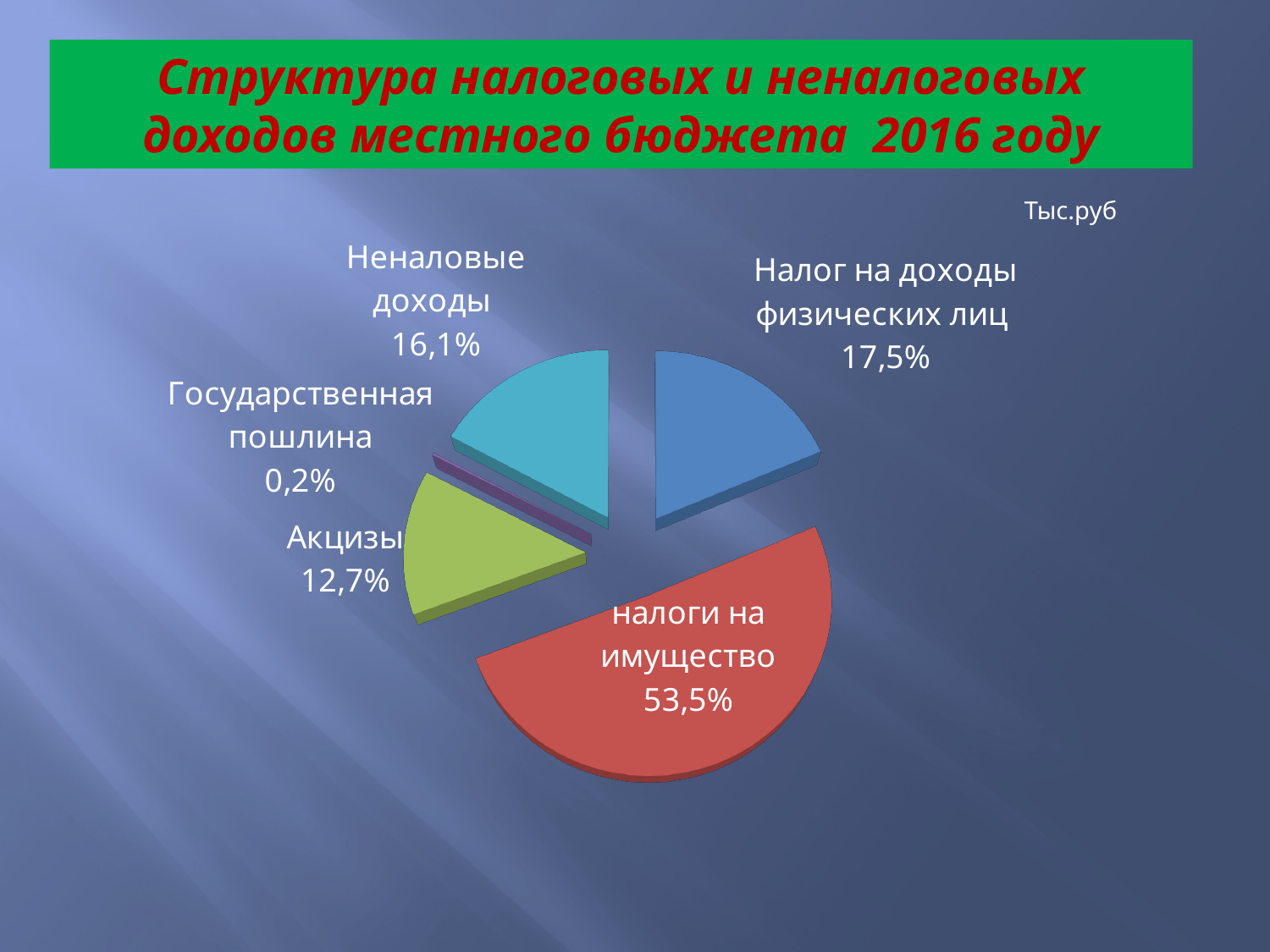
Which is larger: Налог на доходы физических лиц or Неналовые доходы? Налог на доходы физических лиц Which category has the smallest share of the pie? Государственная пошлина What is the value for Налог на доходы физических лиц? 17,5% What type of chart is shown on the slide? pie chart What is the value for Акцизы? 12,7% What colour is the slice for налоги на имущество? red What share of the pie is налоги на имущество? 53,5% Which category has the largest share of the pie? налоги на имущество How many slices does the pie chart have? 5 What is the value for Неналовые доходы? 16,1% What is the value for Государственная пошлина? 0,2% What is the difference between налоги на имущество and Налог на доходы физических лиц? 36,0%